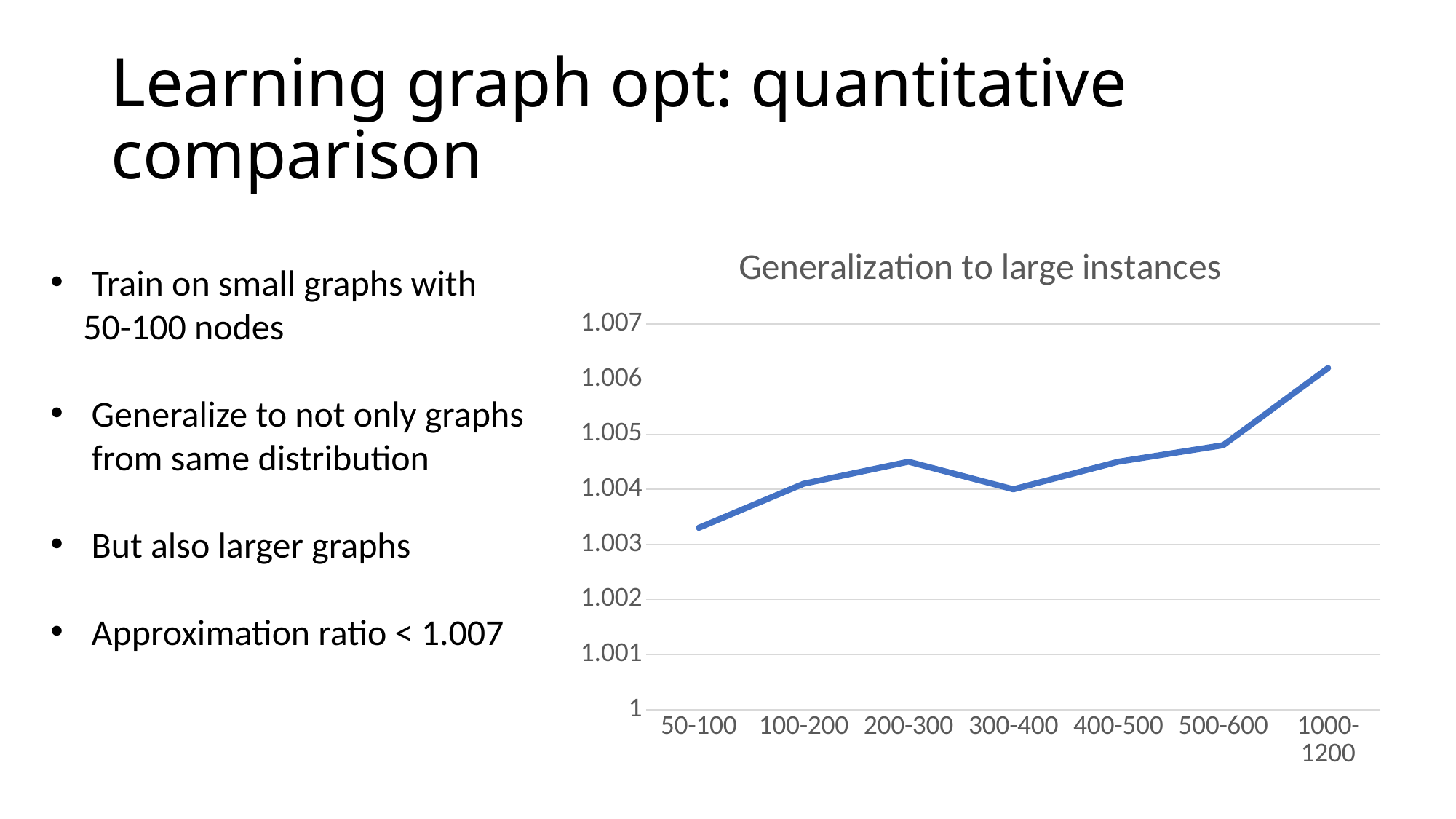
Is the value for 50-100 greater or less than 1.004? less Which has the larger value, 200-300 or 300-400? 200-300 Which category has the highest value? 1000-1200 How many node-range categories are plotted along the x axis? 7 Is the value for 200-300 greater or less than 1.004? greater What is the title of the chart? Generalization to large instances Which category has the lowest value? 50-100 What kind of chart is shown on the slide? line chart Which has the larger value, 50-100 or 100-200? 100-200 Overall, do the values rise or fall from 50-100 to 1000-1200? rise